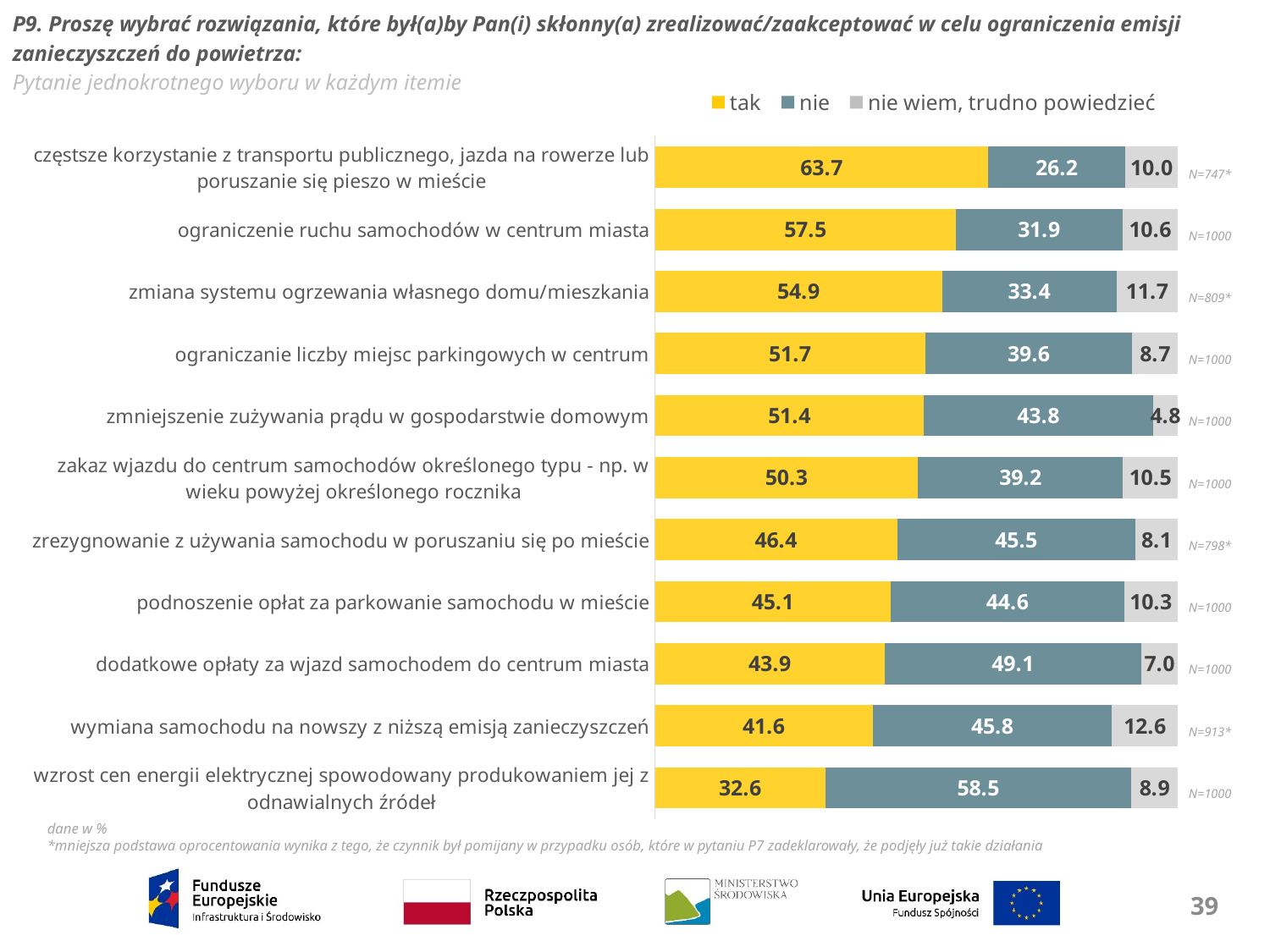
What is the total of the stacked bar for "częstsze korzystanie z transportu publicznego, jazda na rowerze lub poruszanie się pieszo w mieście"? 99.9 What is the value for "nie wiem, trudno powiedzieć" for "wymiana samochodu na nowszy z niższą emisją zanieczyszczeń"? 12.6 Which category has the lowest value for "tak"? wzrost cen energii elektrycznej spowodowany produkowaniem jej z odnawialnych źródeł What is the difference between the "tak" and "nie" values for "ograniczanie liczby miejsc parkingowych w centrum"? 12.1 How many series does the legend list? 3 Which category has the highest value for "tak"? częstsze korzystanie z transportu publicznego, jazda na rowerze lub poruszanie się pieszo w mieście What is the value for "nie" for "wzrost cen energii elektrycznej spowodowany produkowaniem jej z odnawialnych źródeł"? 58.5 What is the value for "tak" for "ograniczenie ruchu samochodów w centrum miasta"? 57.5 Which category has the lowest value for "nie wiem, trudno powiedzieć"? zmniejszenie zużywania prądu w gospodarstwie domowym How many categories (items) are shown in the chart? 11 What kind of chart is shown on the slide? stacked bar chart For "dodatkowe opłaty za wjazd samochodem do centrum miasta", which is larger: "tak" or "nie"? nie